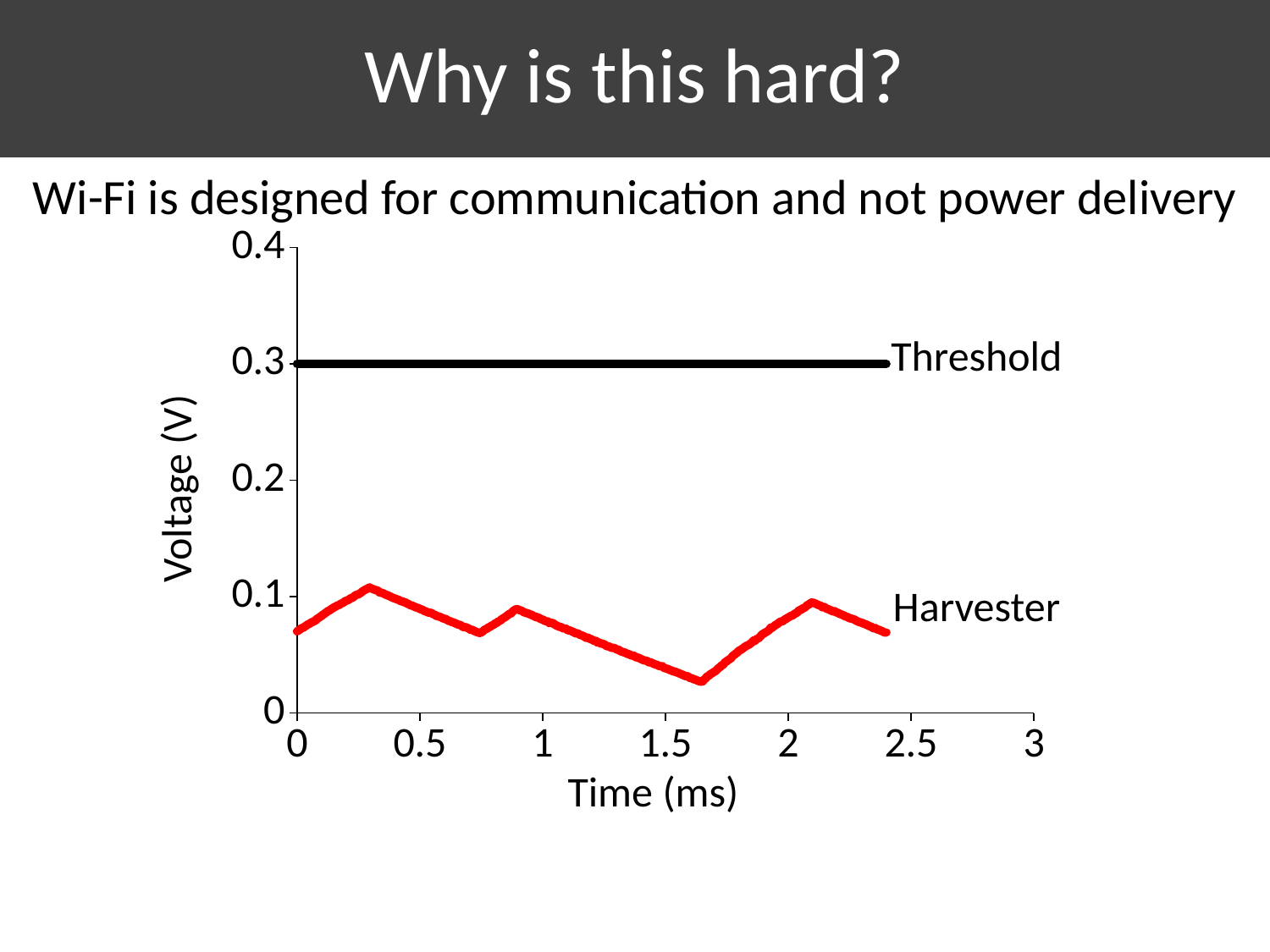
How many series are plotted on the chart? 2 Does the Threshold line rise, fall, or stay constant over time? stays constant What is the label of the x axis? Time (ms) What colour is the Harvester line? red Which series has the higher values, Threshold or Harvester? Threshold Is the Harvester value at 1 ms greater or less than 0.2? less Is the highest point of the Harvester line greater or less than 0.2? less What kind of chart is shown on the slide? line chart Which series reaches the highest voltage on the chart? Threshold Is the Harvester value at 1.5 ms greater or less than 0.1? less What voltage does the Threshold line sit at? 0.3